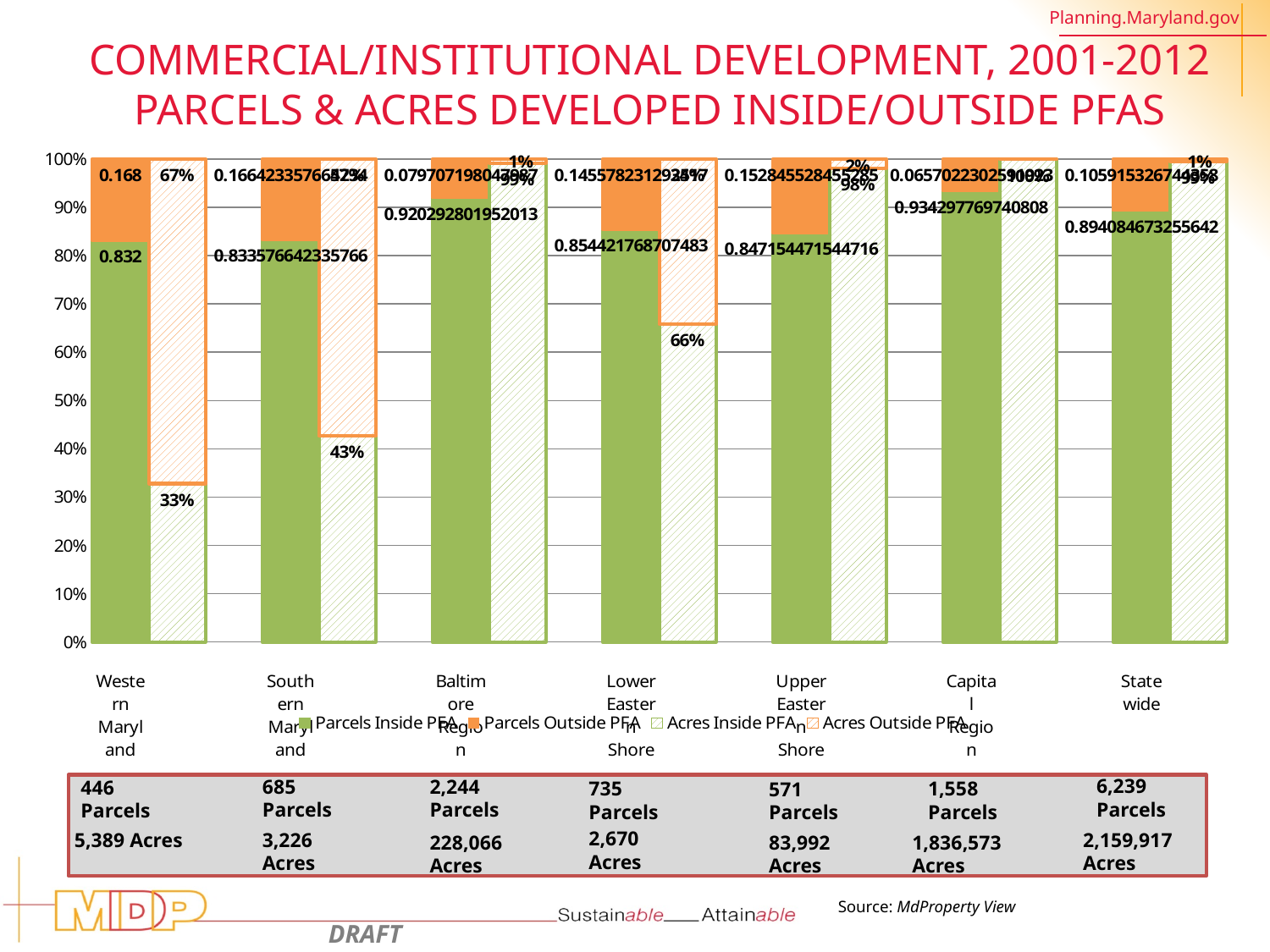
What is the Acres Inside PFA value for Western Maryland? 33% How many regions (categories) are shown along the x axis of the chart? 7 Which region has the highest Parcels Inside PFA value? Capital Region What is the difference between the Acres Outside PFA and Acres Inside PFA values for Western Maryland? 34 percentage points Which is larger, the Acres Inside PFA value for Lower Eastern Shore or for Southern Maryland? Lower Eastern Shore What is the Acres Inside PFA value for Upper Eastern Shore? 98% What kind of chart is shown on the slide? Stacked bar chart How many series does the chart legend list? 4 Which region has the lowest Acres Inside PFA share? Western Maryland What is the Parcels Inside PFA value for Western Maryland? 0.832 Is the Parcels Inside PFA value for Baltimore Region greater or less than 90%? greater What is the Acres Inside PFA value for Lower Eastern Shore? 66%